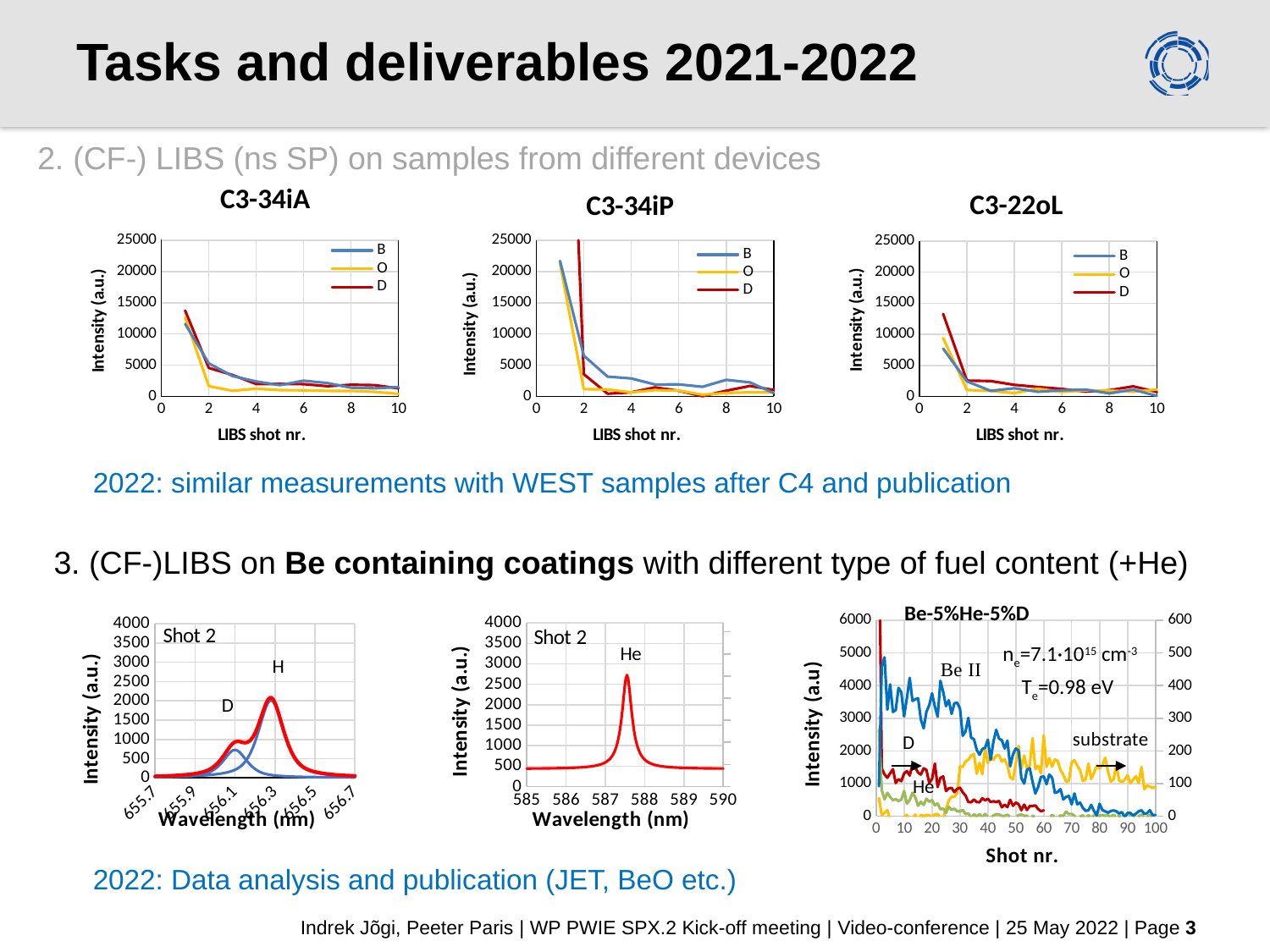
In the C3-34iA chart, do the values of the D series rise or fall as the LIBS shot number increases? fall In the C3-34iP chart, which series has the highest value at LIBS shot 2? B What kind of chart is the C3-34iA chart? line chart In the bottom-left chart (Shot 2, D and H), is the peak intensity of D greater or less than 1000? less In the bottom-middle chart (Shot 2, He), is the peak intensity greater or less than 2500? greater In the Be-5%He-5%D chart, what is the x-axis title? Shot nr. In the C3-22oL chart, what are the legend entries? B, O, D In the C3-34iA chart, how many series does the legend list? 3 In the C3-22oL chart, which series has the highest value at LIBS shot 1? D In the C3-34iP chart, is the value of the B series at LIBS shot 1 greater or less than 20000? greater